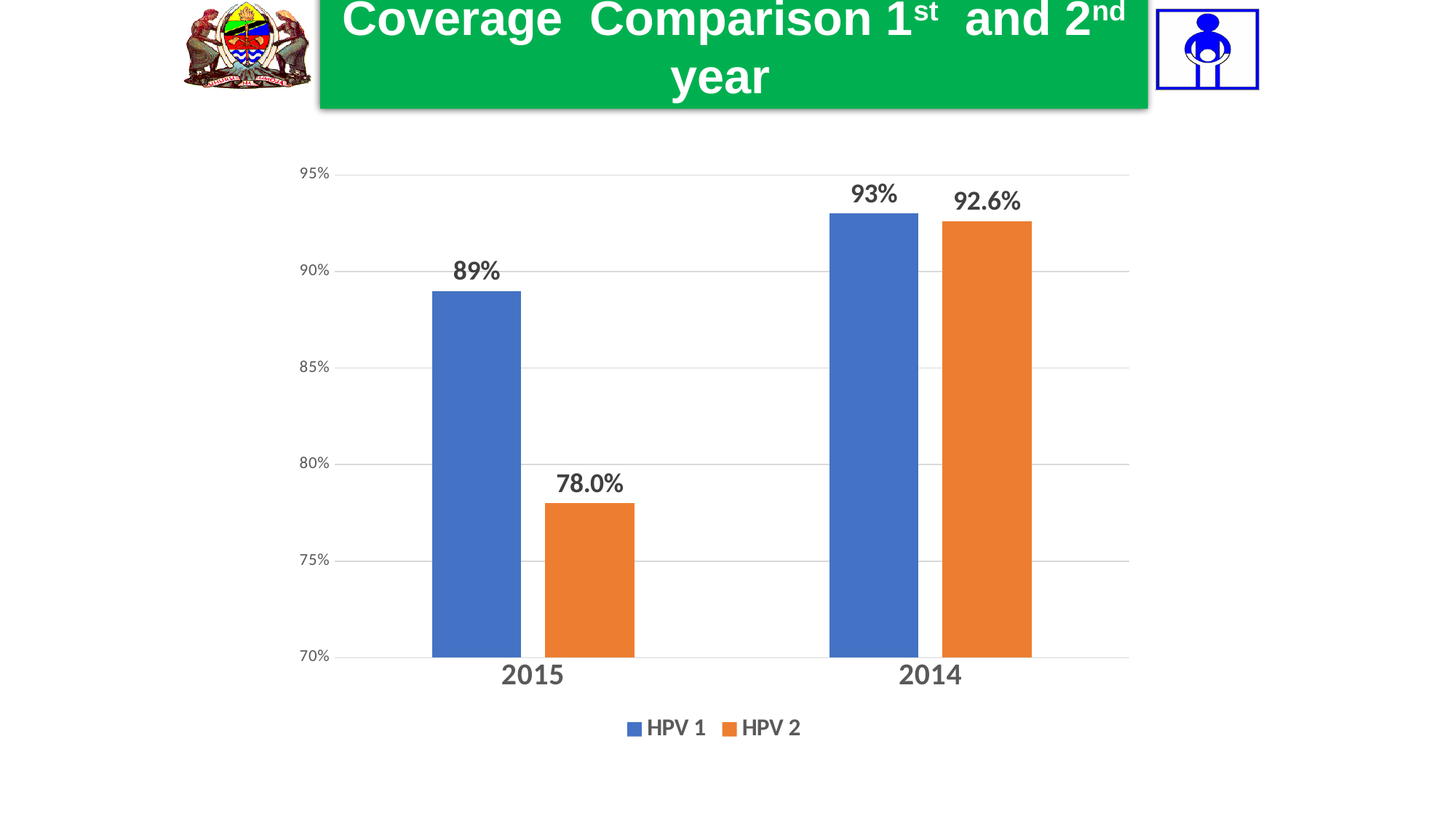
Is the HPV 2 value for 2015 greater or less than 80%? less What is the difference between HPV 1 and HPV 2 coverage in 2015? 11 percentage points What is the HPV 1 coverage value for 2014? 93% Which is larger in 2015, HPV 1 or HPV 2 coverage? HPV 1 What is the HPV 1 coverage value for 2015? 89% What is the HPV 2 coverage value for 2014? 92.6% What kind of chart is shown on the slide? Bar chart How many series does the legend list? 2 Which year has the highest HPV 1 coverage? 2014 Which year has the lowest HPV 2 coverage? 2015 What colour are the HPV 2 bars? Orange What is the HPV 2 coverage value for 2015? 78.0%